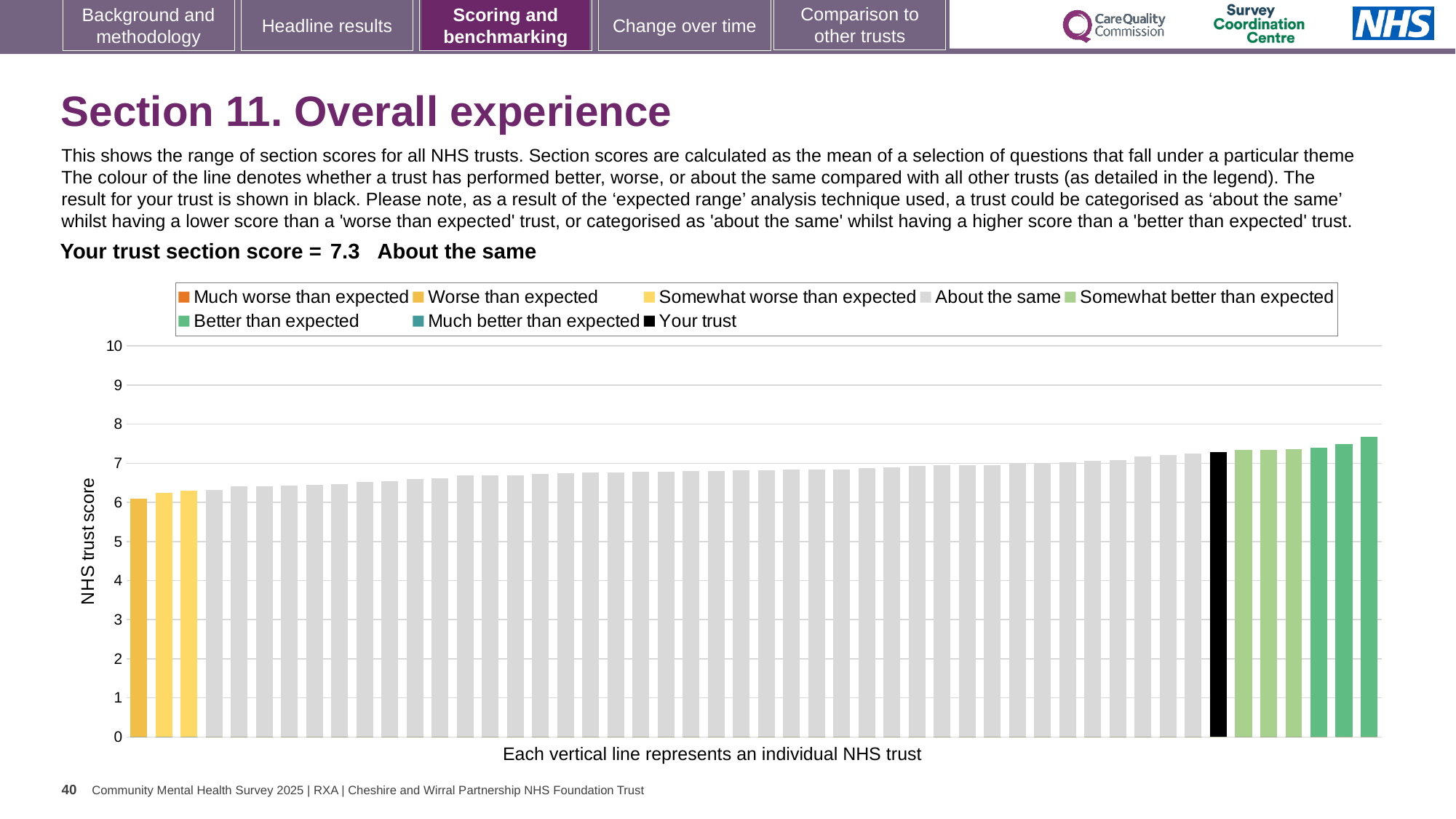
What is the section score for your trust shown on the slide? 7.3 Which legend category does the tallest bar on the chart belong to? Better than expected Is the value of the leftmost (lowest) bar greater or less than 5? greater What is the title of the vertical axis? NHS trust score Do the bar values rise or fall from left to right along the x axis? Rise Is the value of the black 'Your trust' bar greater or less than 7? greater How many entries does the chart legend list? 8 Which legend category does the shortest bar on the chart belong to? Worse than expected Which category is your trust's section score placed in? About the same Is the value of the rightmost (highest) bar greater or less than 8? less What colour is the bar representing your trust? Black What kind of chart is shown on the slide? Bar chart